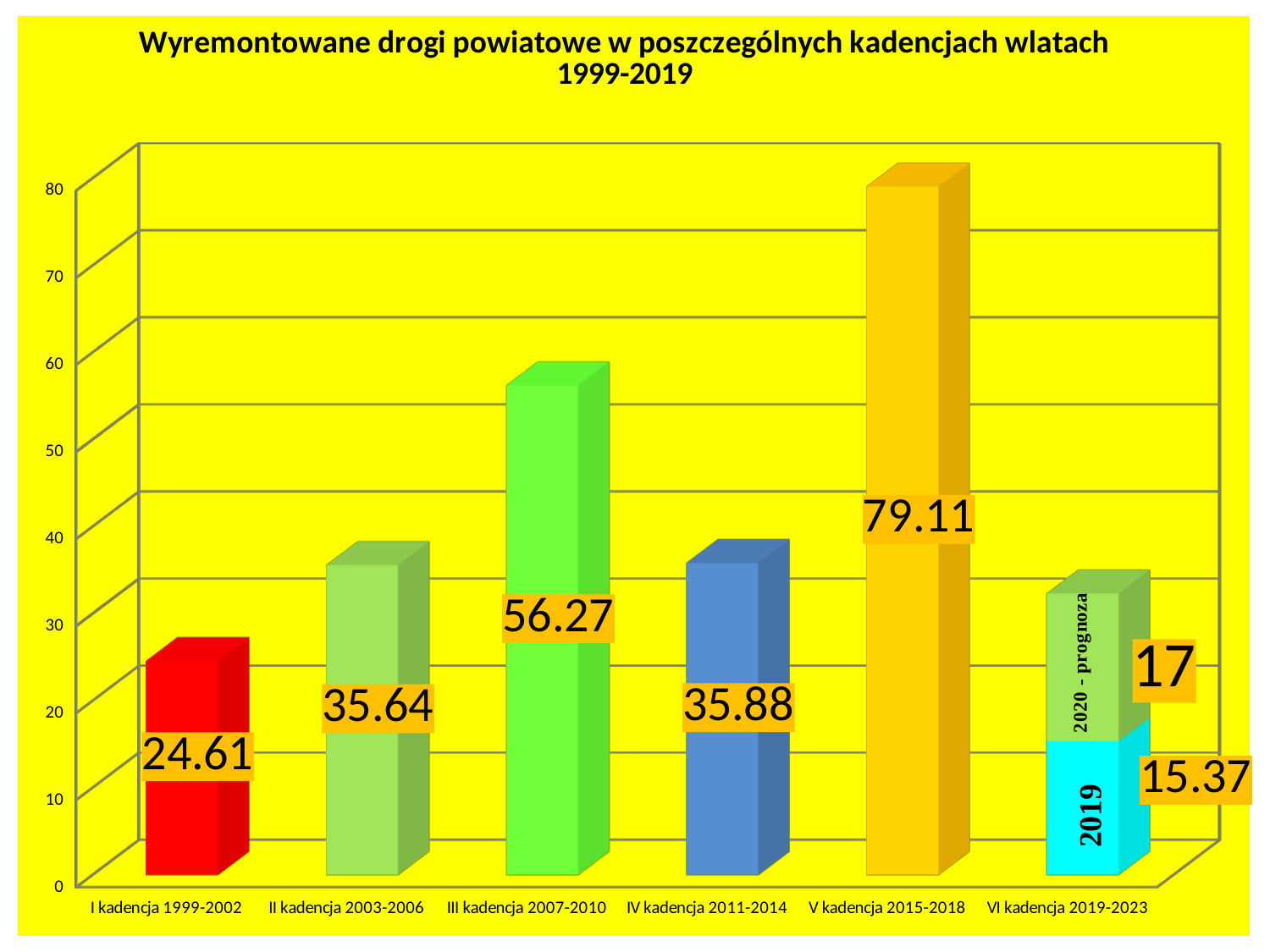
What kind of chart is shown on the slide? Bar chart Which is larger, the value for III kadencja 2007-2010 or the value for II kadencja 2003-2006? III kadencja 2007-2010 Which kadencja has the highest value? V kadencja 2015-2018 What value is shown for V kadencja 2015-2018? 79.11 What is the title of the chart? Wyremontowane drogi powiatowe w poszczególnych kadencjach wlatach 1999-2019 What is the difference between the values for V kadencja 2015-2018 and III kadencja 2007-2010? 22.84 How many kadencja categories are shown on the x axis? 6 What value is shown for I kadencja 1999-2002? 24.61 What value is shown for the 2020 - prognoza segment of VI kadencja 2019-2023? 17 What value is shown for the 2019 segment of VI kadencja 2019-2023? 15.37 What is the total of the stacked bar for VI kadencja 2019-2023? 32.37 Which kadencja has the lowest value? I kadencja 1999-2002